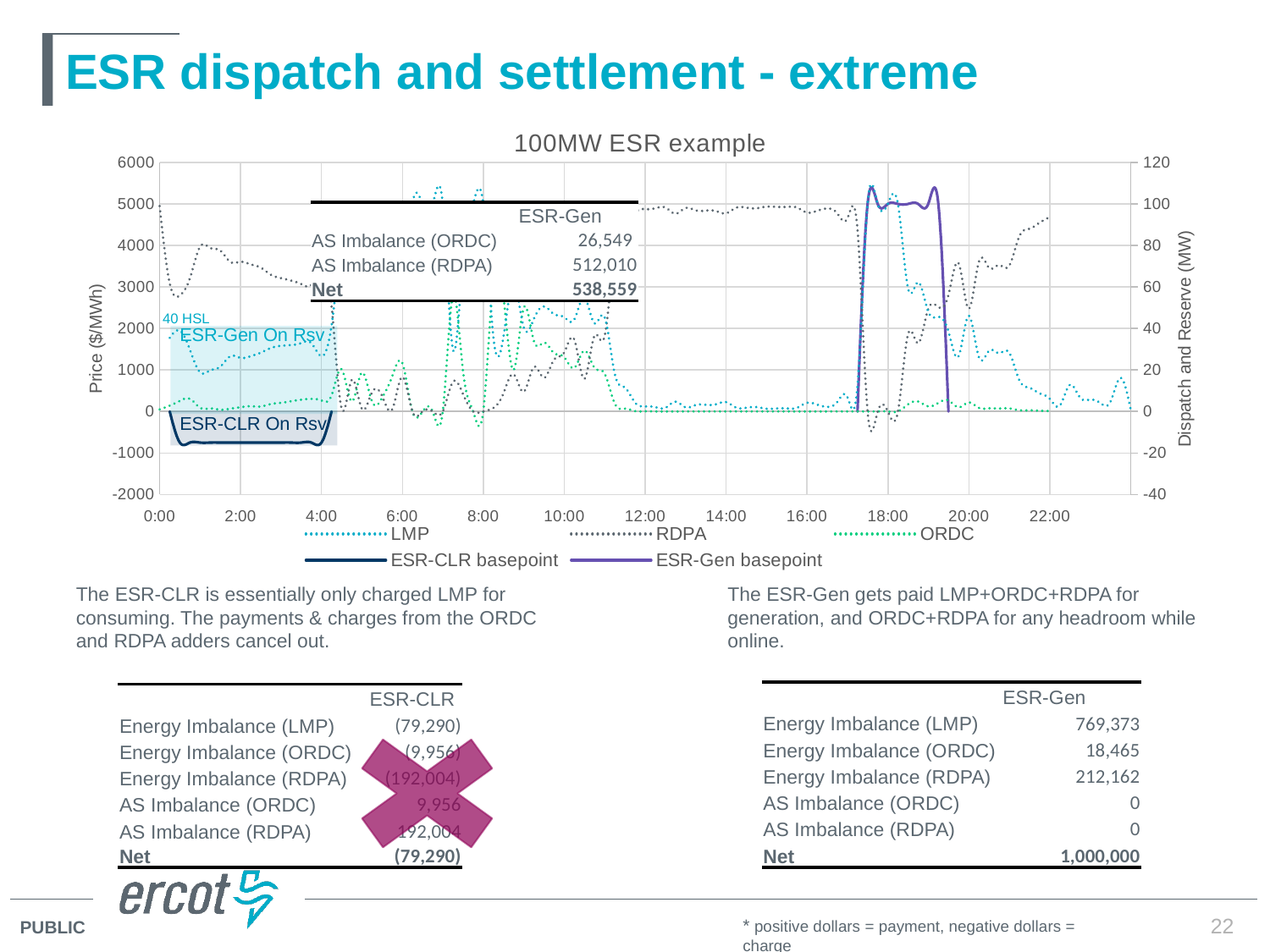
What is the label of the left vertical axis of the chart? Price ($/MWh) What is the title of the chart? 100MW ESR example Is the value of the ESR-CLR basepoint series between 0:00 and 4:00 greater or less than 0 MW? less Which series in the chart is drawn as a solid purple line? ESR-Gen basepoint What is the first time label shown on the x axis of the chart? 0:00 How many series does the chart legend list? 5 What is the last time label shown on the x axis of the chart? 22:00 What type of chart is shown on the slide? line chart Is the peak value of the ESR-Gen basepoint series around 18:00 greater or less than 80 MW? greater What is the minimum value shown on the left vertical axis (Price) of the chart? -2000 What is the maximum value shown on the right vertical axis (Dispatch and Reserve) of the chart? 120